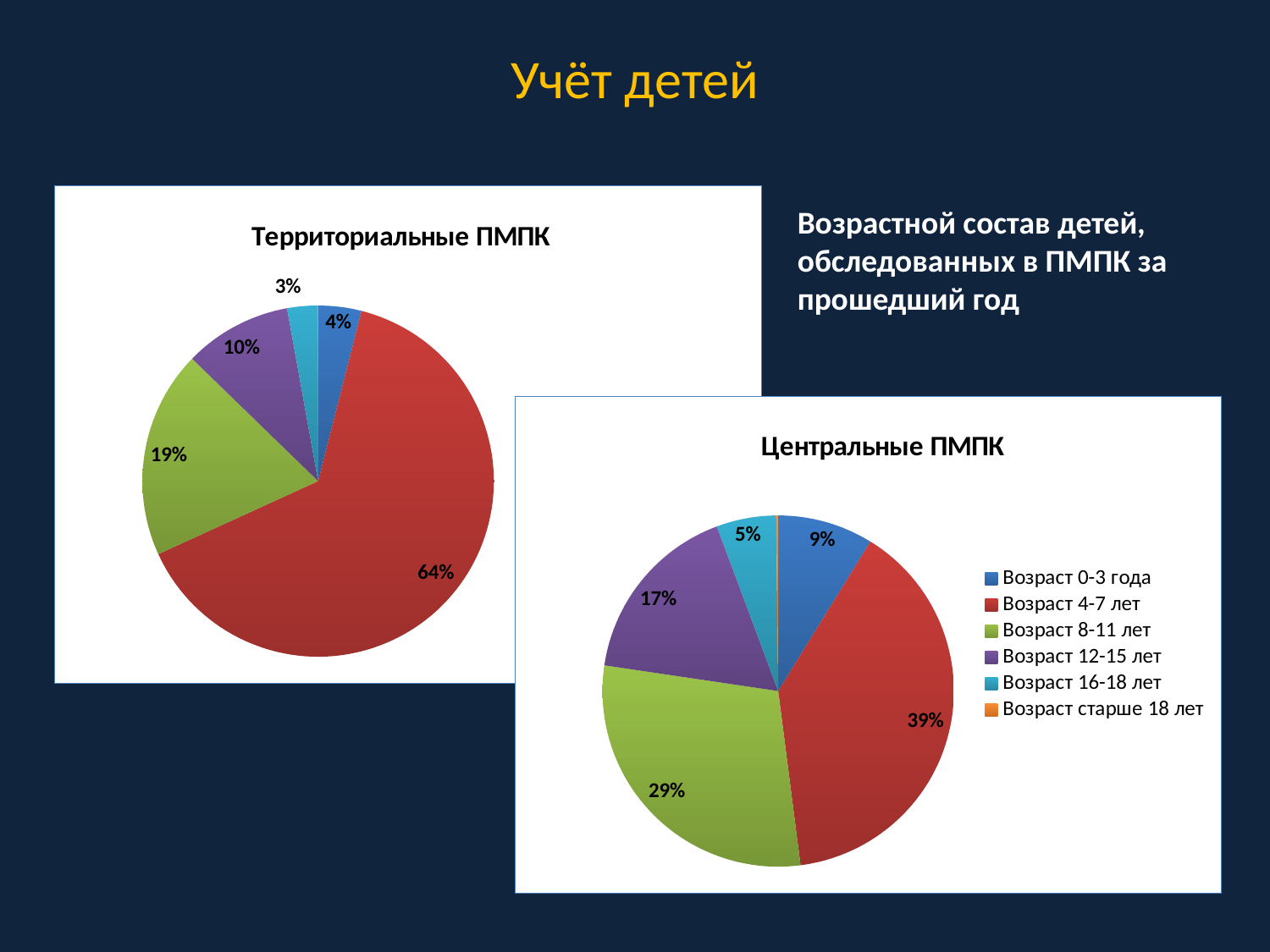
What is the title of the chart on the right of the slide? Центральные ПМПК In the "Территориальные ПМПК" chart, which age group has the largest slice? Возраст 4-7 лет In the "Центральные ПМПК" chart, what is the difference between the shares for Возраст 4-7 лет and Возраст 8-11 лет? 10% In the "Центральные ПМПК" chart, what share is shown for Возраст 12-15 лет? 17% In the "Центральные ПМПК" chart, what share is shown for Возраст 4-7 лет? 39% Which legend entry is shown in red? Возраст 4-7 лет In the "Центральные ПМПК" chart, which is larger: the share for Возраст 8-11 лет or the share for Возраст 0-3 года? Возраст 8-11 лет What kind of chart is the "Территориальные ПМПК" chart? pie chart In the "Территориальные ПМПК" chart, what share is shown for Возраст 8-11 лет? 19% In the "Территориальные ПМПК" chart, what is the difference between the shares for Возраст 12-15 лет and Возраст 16-18 лет? 7% How many entries does the legend on the slide list? 6